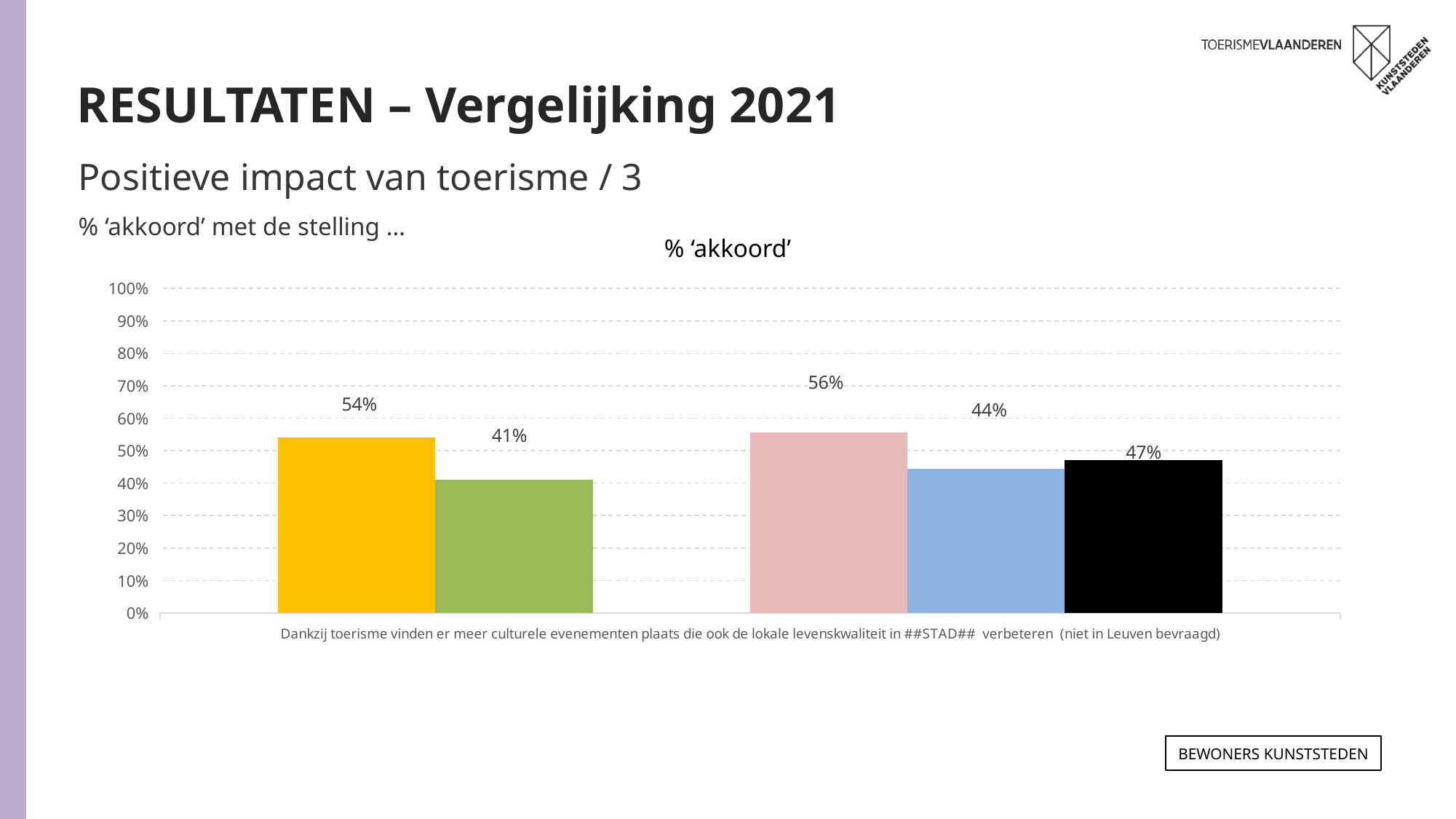
Which bar has the highest value? The pink bar (56%) What is the value shown on the green bar? 41% What is the value shown on the pink bar? 56% What is the value shown on the blue bar? 44% What is the value shown on the black bar? 47% Which is larger, the value of the black bar or the blue bar? The black bar What is the difference between the yellow bar and the green bar? 13 percentage points What is the title of the chart? % ‘akkoord’ What kind of chart is shown on the slide? Bar chart What is the value shown on the yellow bar? 54% How many bars are plotted in the chart? 5 Which bar has the lowest value? The green bar (41%)